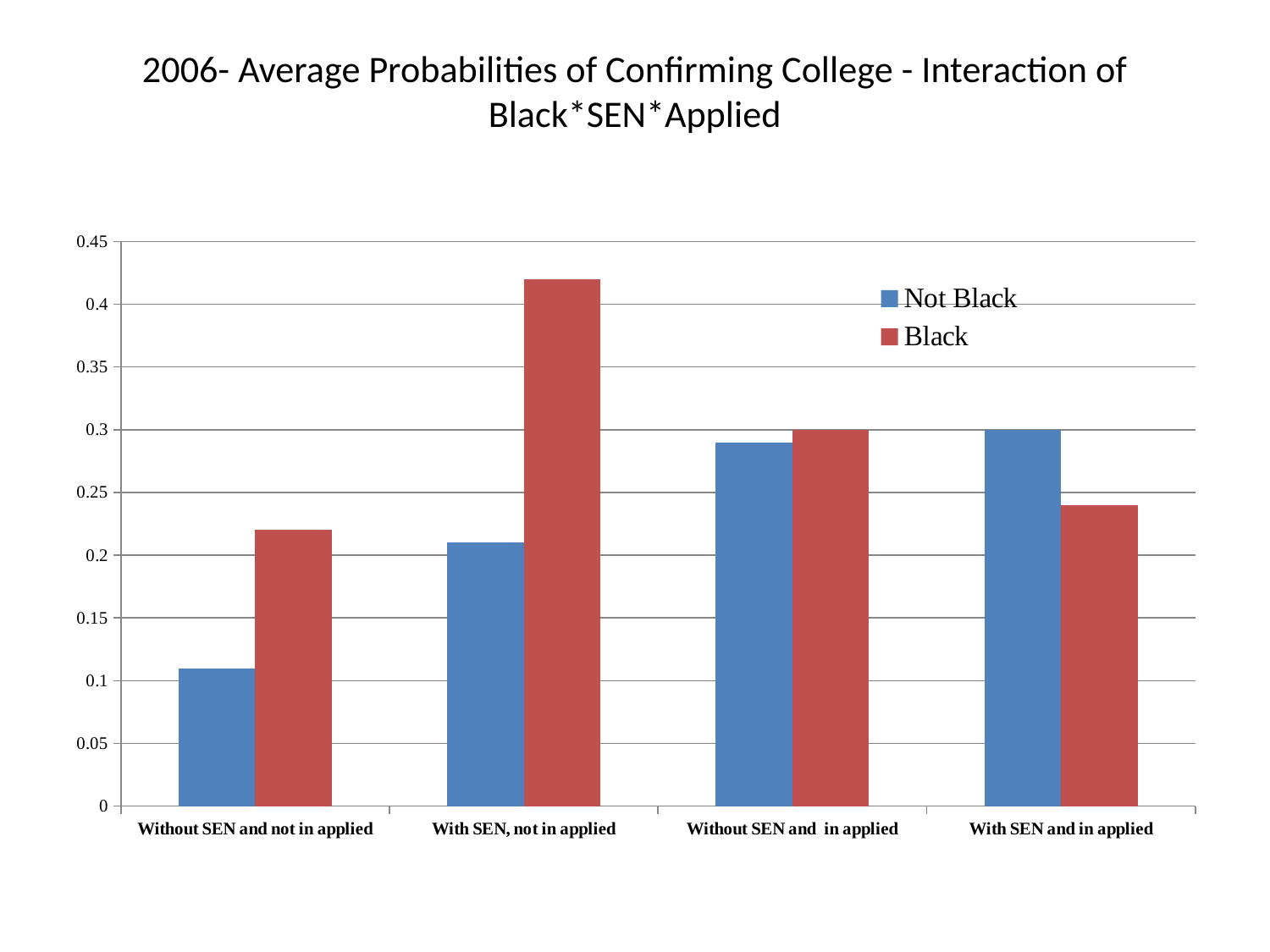
What type of chart is shown on the slide? bar chart In the 'With SEN and in applied' category, which series has the larger value, Not Black or Black? Not Black Is the value for Black in the 'With SEN, not in applied' category greater or less than 0.4? greater How many categories are shown on the x axis? 4 Which category has the highest value for the Black series? With SEN, not in applied Do the Not Black values rise or fall moving from left to right across the categories? rise Which category has the lowest value for the Not Black series? Without SEN and not in applied What colour represents the Black series in the chart? red Is the value for Black in the 'With SEN and in applied' category greater or less than 0.25? less In the 'Without SEN and not in applied' category, which series has the larger value, Not Black or Black? Black How many series does the legend list? 2 Is the value for Not Black in the 'Without SEN and not in applied' category greater or less than 0.15? less